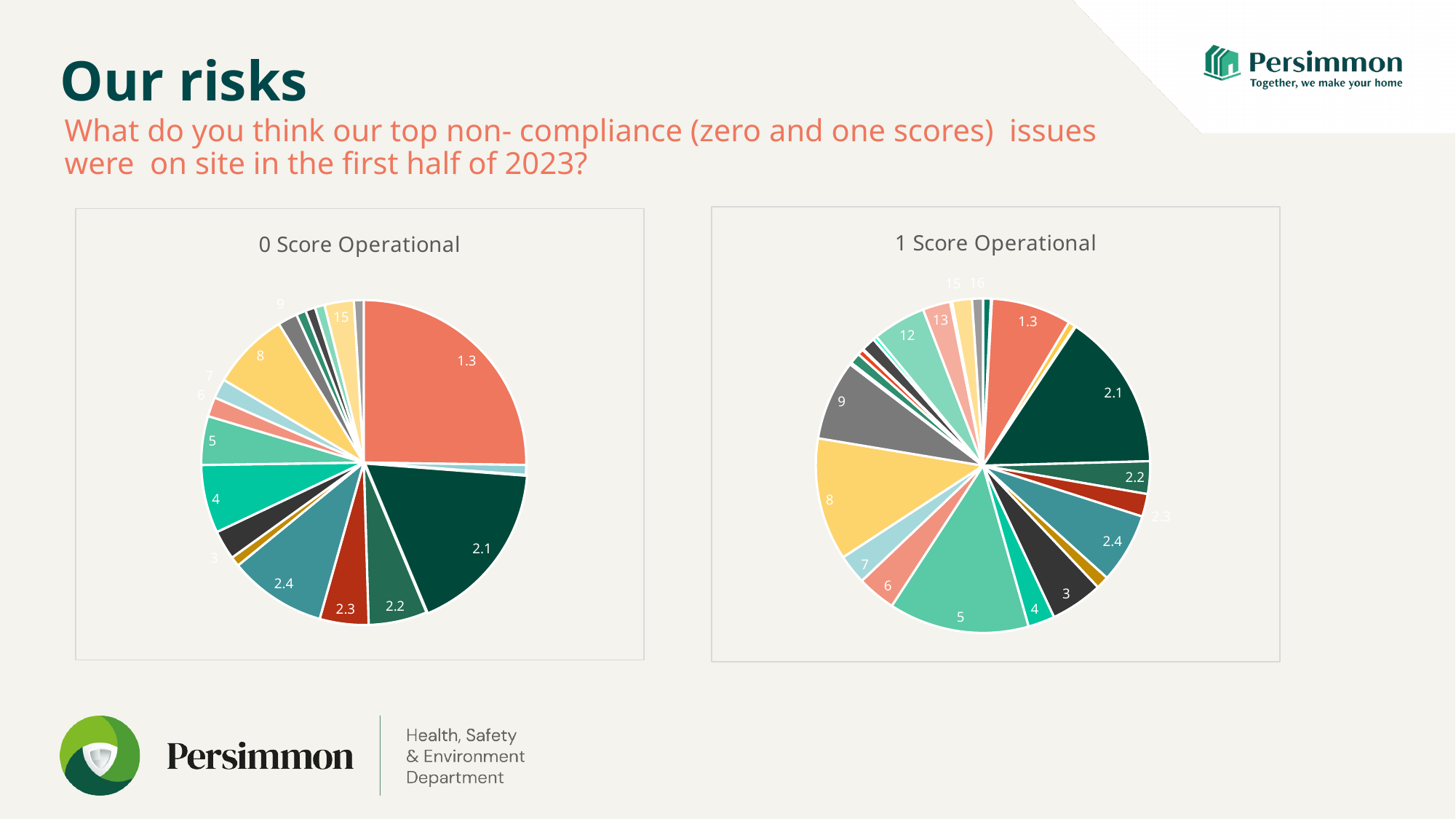
What kind of chart is the "0 Score Operational" chart? pie chart What kind of chart is the "1 Score Operational" chart? pie chart In the "1 Score Operational" chart, which slice is larger, 2.1 or 2.2? 2.1 In the "0 Score Operational" chart, which slice is larger, 4 or 3? 4 What is the title of the pie chart on the left of the slide? 0 Score Operational In the "0 Score Operational" chart, which slice is larger, 2.1 or 2.2? 2.1 How many charts are shown on the slide? 2 What is the title of the pie chart on the right of the slide? 1 Score Operational In the "0 Score Operational" chart, which category has the largest slice? 1.3